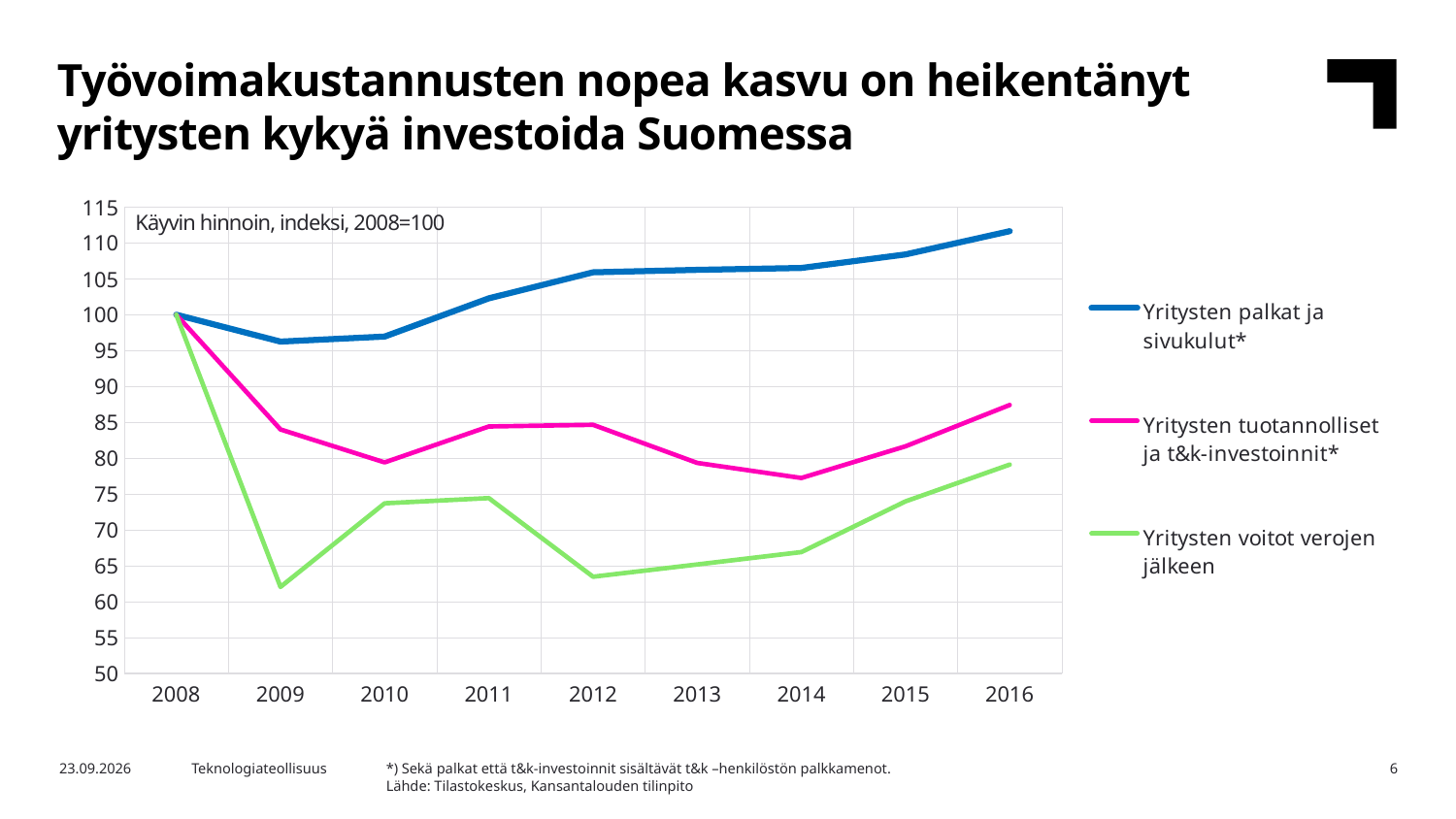
How many series does the legend list? 3 How many years are shown on the x axis? 9 Does Yritysten palkat ja sivukulut* rise or fall from 2010 to 2016? rise What base year and index value does the chart's subtitle state? 2008=100 Is the value for Yritysten palkat ja sivukulut* in 2016 greater or less than 110? greater Is the value for Yritysten tuotannolliset ja t&k-investoinnit* in 2014 greater or less than 80? less What is the value of Yritysten palkat ja sivukulut* in 2008? 100 Is the value for Yritysten voitot verojen jälkeen in 2009 greater or less than 65? less In which year is Yritysten voitot verojen jälkeen at its lowest? 2009 In 2016, which is larger: Yritysten palkat ja sivukulut* or Yritysten tuotannolliset ja t&k-investoinnit*? Yritysten palkat ja sivukulut* In which year is Yritysten palkat ja sivukulut* at its highest? 2016 What kind of chart is shown on the slide? line chart